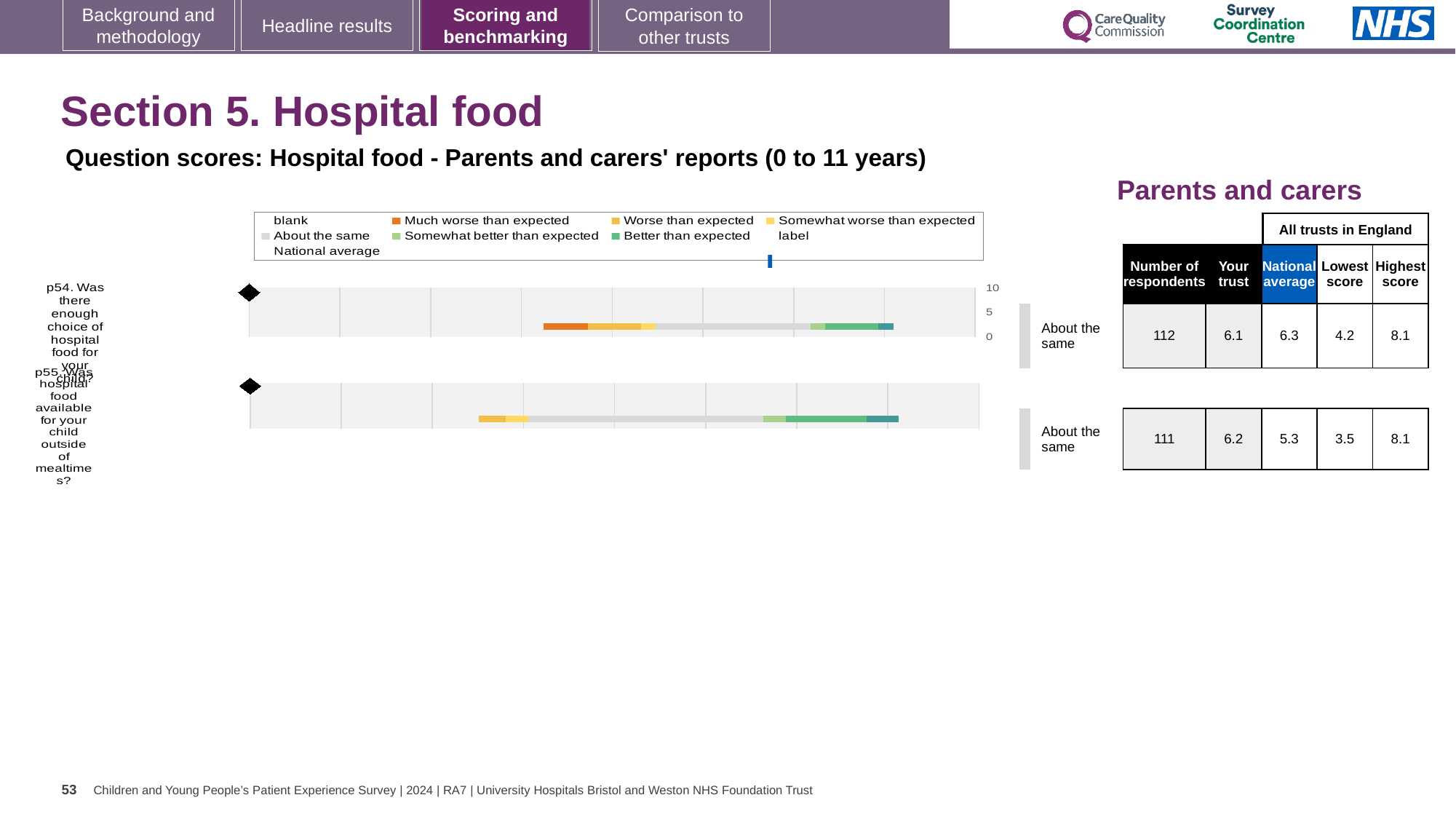
What is the lowest score among all trusts in England for p55? 3.5 By how much does the 'Your trust' score for p55 exceed the national average for p55? 0.9 What is the 'Your trust' score for p54 (enough choice of hospital food for your child)? 6.1 Which question has the higher national average, p54 or p55? p54 How many questions are plotted in the hospital food chart? 2 What is the difference between the national average and the 'Your trust' score for p54? 0.2 What benchmark category is shown for p54? About the same Which question has the higher 'Your trust' score, p54 or p55? p55 What is the highest score among all trusts in England for p54? 8.1 How many respondents answered p54? 112 What is the national average score for p55 (hospital food available outside of mealtimes)? 5.3 What kind of chart is used to show the question scores for hospital food? bar chart